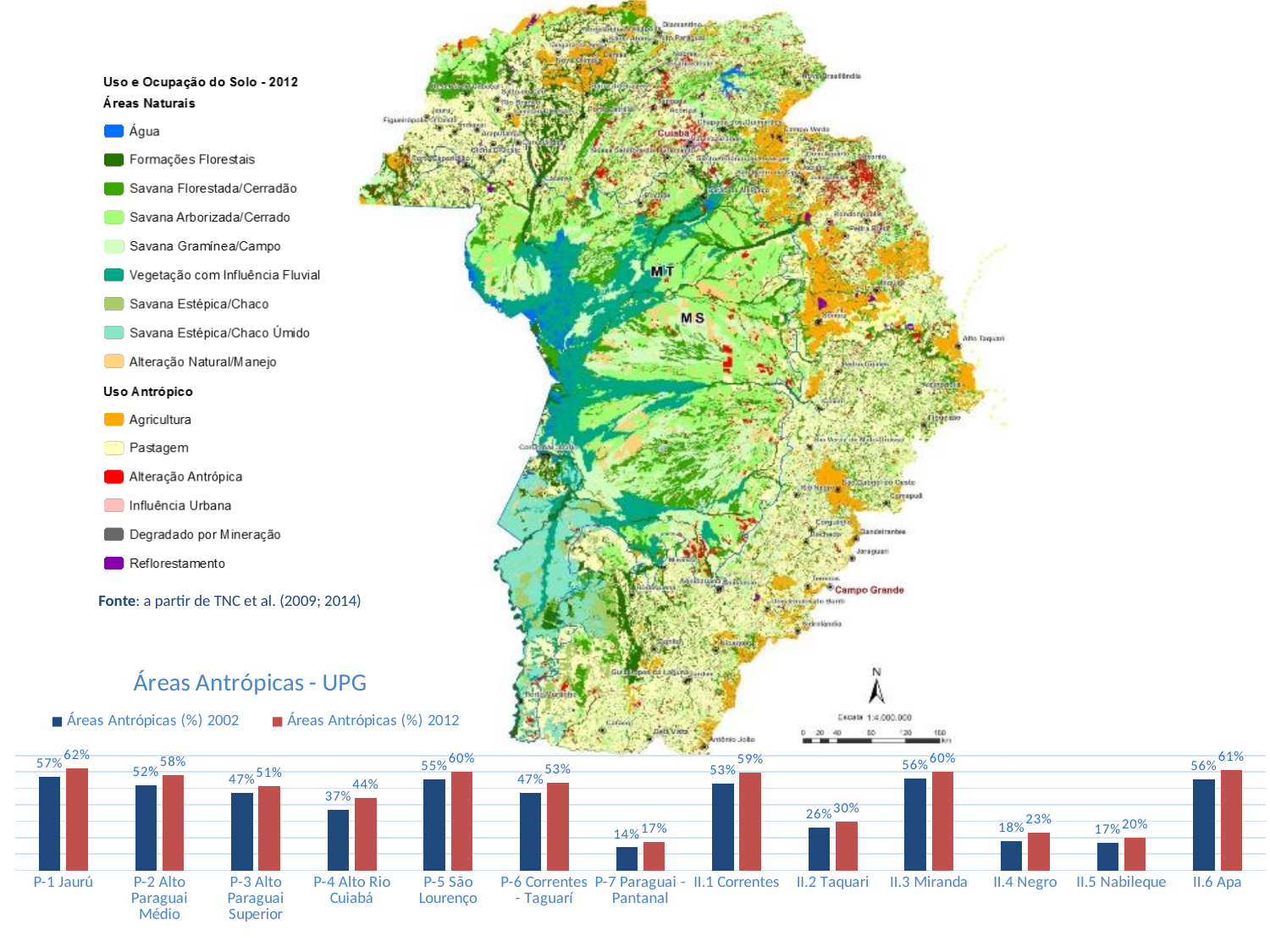
In the 'Áreas Antrópicas - UPG' chart, what is the value of Áreas Antrópicas (%) 2012 for II.4 Negro? 23% What kind of chart is 'Áreas Antrópicas - UPG'? Bar chart In the 'Áreas Antrópicas - UPG' chart, what is the value of Áreas Antrópicas (%) 2002 for P-4 Alto Rio Cuiabá? 37% In the 'Áreas Antrópicas - UPG' chart, what is the value of Áreas Antrópicas (%) 2012 for P-1 Jaurú? 62% In the 'Áreas Antrópicas - UPG' chart, what is the difference between the 2012 and 2002 values for II.2 Taquari? 4% In the 'Áreas Antrópicas - UPG' chart, which is larger: the 2002 value for II.3 Miranda or the 2002 value for II.1 Correntes? II.3 Miranda In the 'Áreas Antrópicas - UPG' chart, which category has the lowest value for Áreas Antrópicas (%) 2002? P-7 Paraguai - Pantanal In the 'Áreas Antrópicas - UPG' chart, which series is shown in red? Áreas Antrópicas (%) 2012 In the 'Áreas Antrópicas - UPG' chart, what is the difference between the 2012 and 2002 values for P-4 Alto Rio Cuiabá? 7% In the 'Áreas Antrópicas - UPG' chart, which category has the highest value for Áreas Antrópicas (%) 2012? P-1 Jaurú How many categories (UPGs) are shown on the x axis of the 'Áreas Antrópicas - UPG' chart? 13 How many series does the legend of the 'Áreas Antrópicas - UPG' chart list? 2